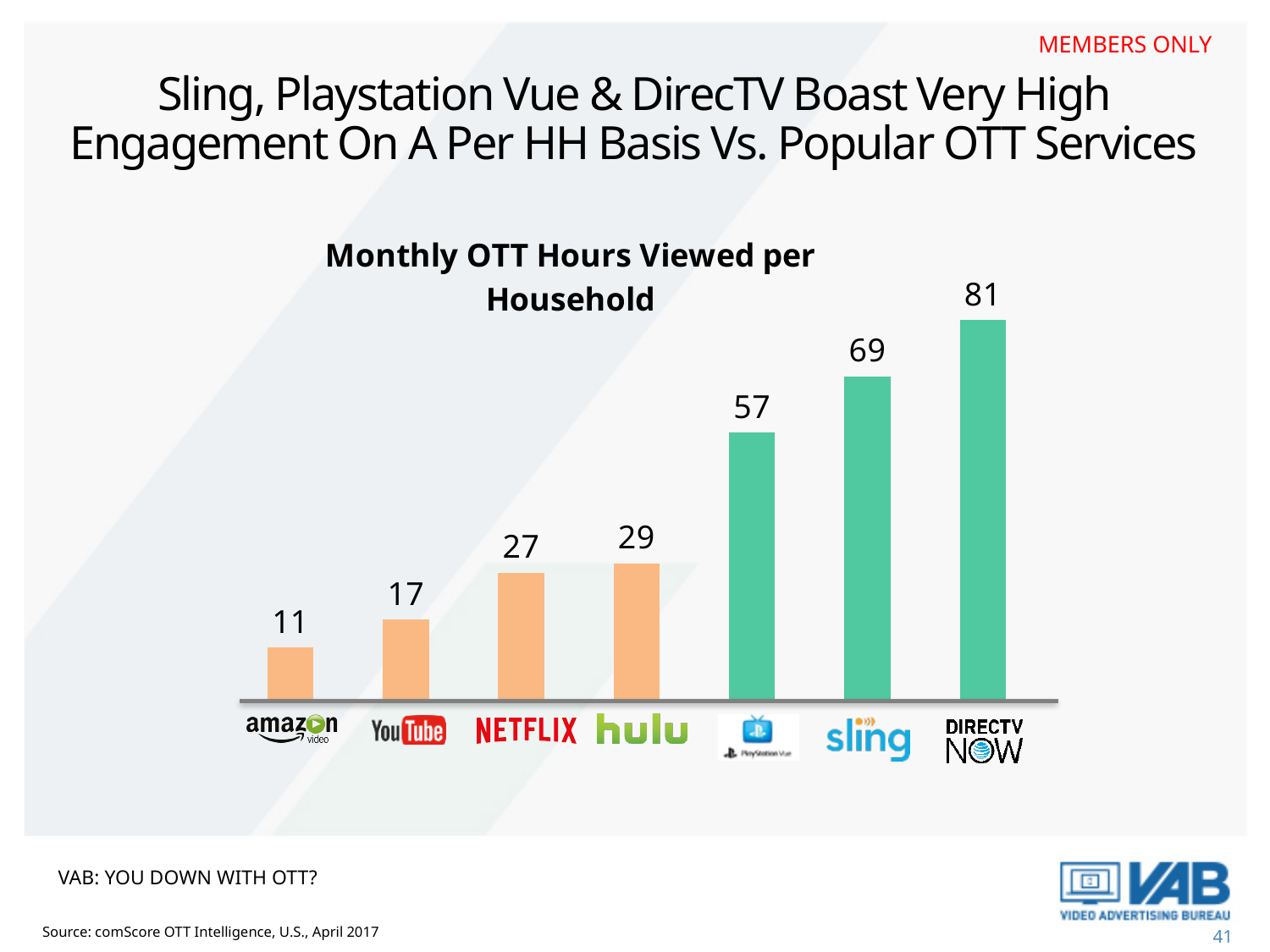
What is the difference in monthly OTT hours viewed per household between PlayStation Vue and YouTube? 40 Which has more monthly OTT hours viewed per household, Hulu or Netflix? Hulu How many services are shown in the chart? 7 What is the monthly OTT hours viewed per household for Netflix? 27 What is the monthly OTT hours viewed per household for Sling? 69 Which service has the highest monthly OTT hours viewed per household? DirecTV Now What is the title of the chart? Monthly OTT Hours Viewed per Household What is the difference in monthly OTT hours viewed per household between DirecTV Now and Hulu? 52 What is the monthly OTT hours viewed per household for Amazon Video? 11 Which service has the lowest monthly OTT hours viewed per household? Amazon Video Do the values rise or fall moving from left to right across the chart? Rise What kind of chart is shown on the slide? Bar chart